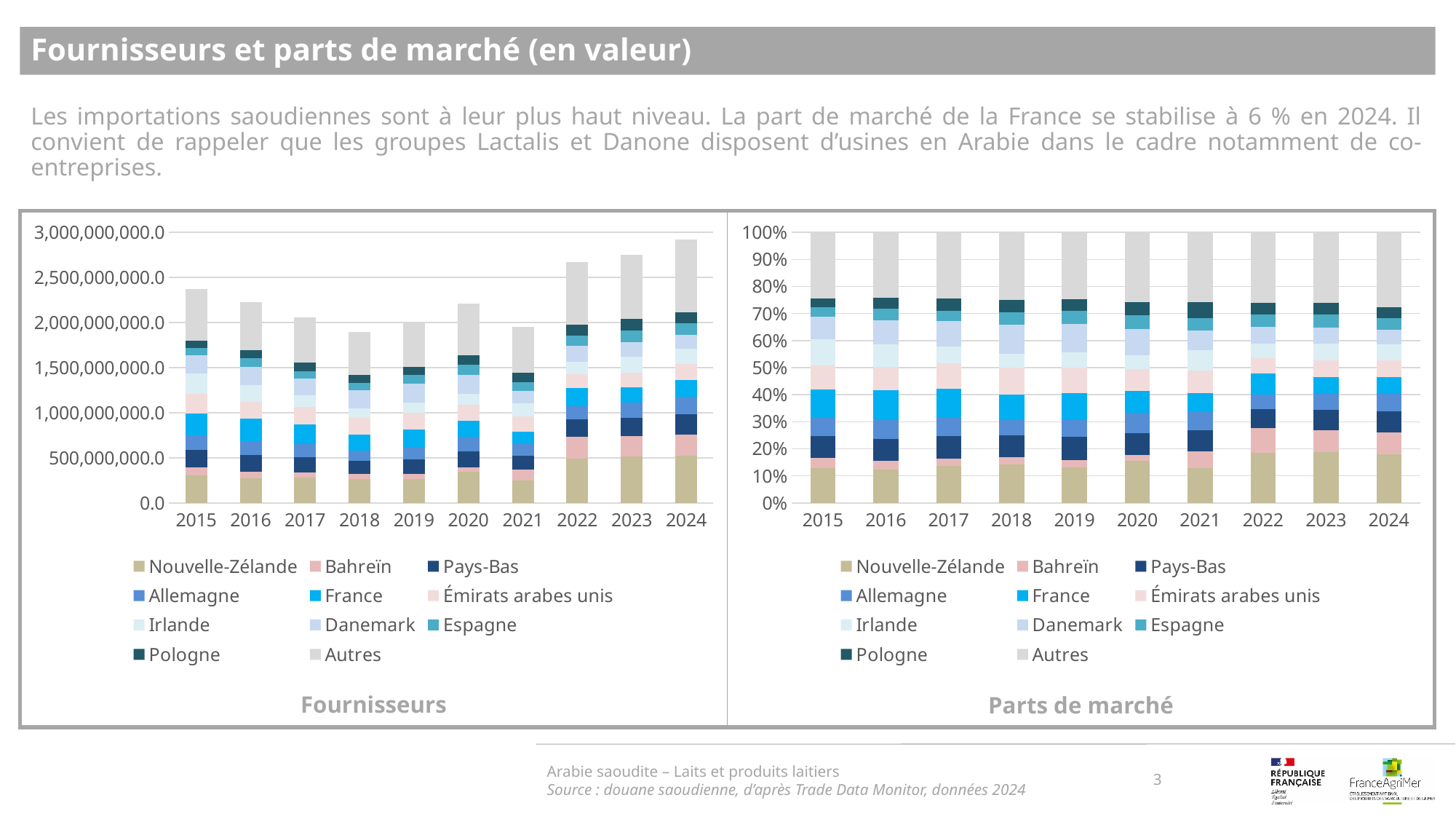
In the 'Parts de marché' chart, is the share of Nouvelle-Zélande in 2024 greater or less than 10%? greater What kind of chart is the 'Fournisseurs' chart on the left? Stacked bar chart What kind of chart is the 'Parts de marché' chart on the right? 100% stacked bar chart In the 'Parts de marché' chart, which series is plotted at the top of each stacked bar? Autres In the 'Fournisseurs' chart, is the total for 2024 greater or less than 2,500,000,000.0? greater In the 'Fournisseurs' chart, do the total bars rise or fall from 2021 to 2024? Rise In the 'Fournisseurs' chart, how many years are shown on the x axis? 10 In the 'Parts de marché' chart, how many series does the legend list? 11 In the 'Parts de marché' chart, which year has the larger share for Nouvelle-Zélande, 2015 or 2022? 2022 In the 'Fournisseurs' chart, which year has the larger total bar, 2021 or 2022? 2022 In the 'Fournisseurs' chart, which year has the highest total bar? 2024 In the 'Fournisseurs' chart, is the total for 2018 greater or less than 2,000,000,000.0? less